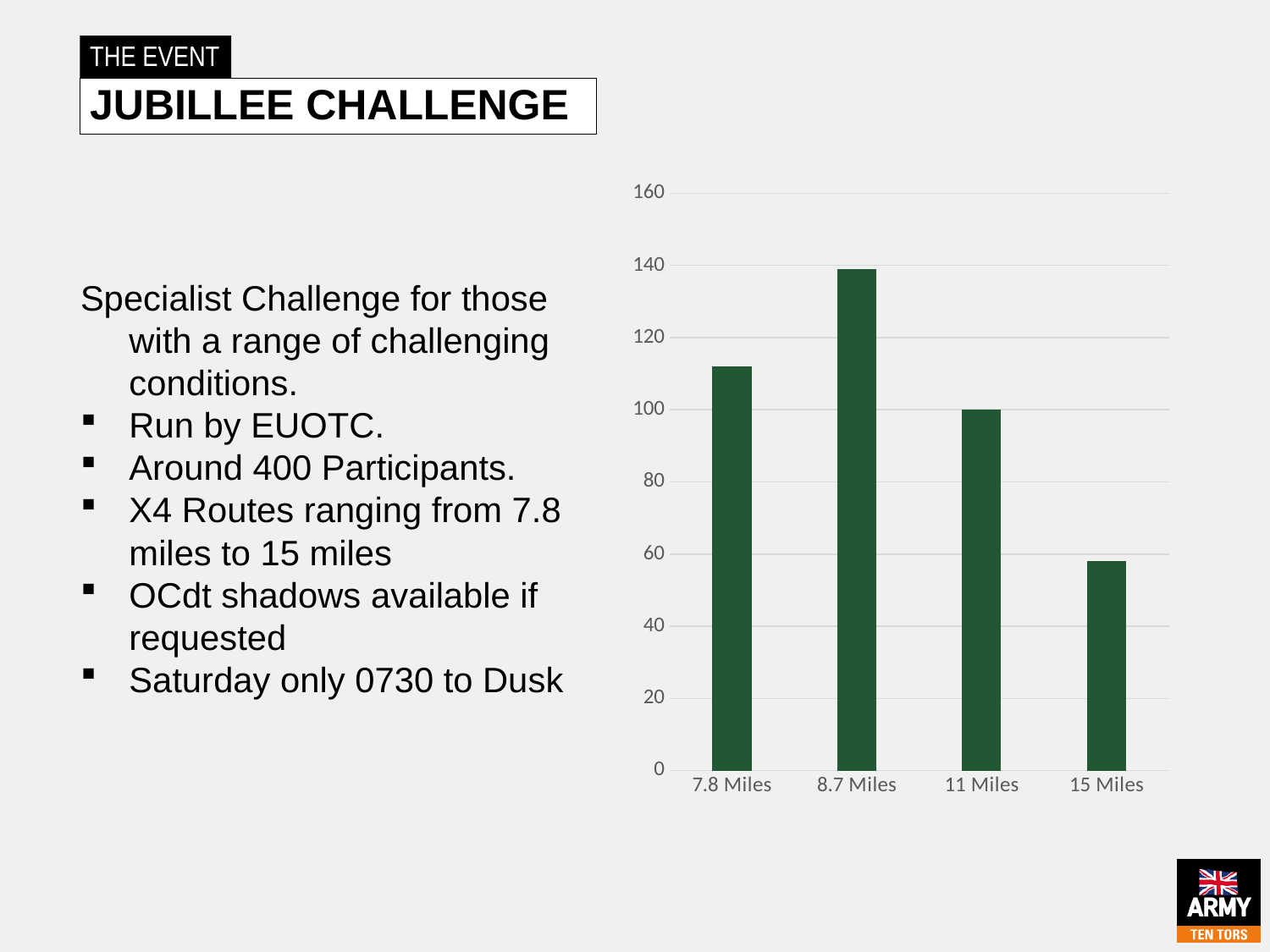
Is the value for 11 Miles greater or less than 120? less Which is larger, the value for 7.8 Miles or the value for 11 Miles? 7.8 Miles Which route has the highest bar in the chart? 8.7 Miles Is the value for 7.8 Miles greater or less than 100? greater How many categories are shown on the x axis of the chart? 4 Is the value for 15 Miles greater or less than 80? less Which route has the lowest bar in the chart? 15 Miles What is the highest value shown on the chart's vertical axis? 160 Do the values fall steadily from 8.7 Miles to 15 Miles along the x axis? yes Which is larger, the value for 15 Miles or the value for 8.7 Miles? 8.7 Miles What kind of chart is shown on the slide? bar chart